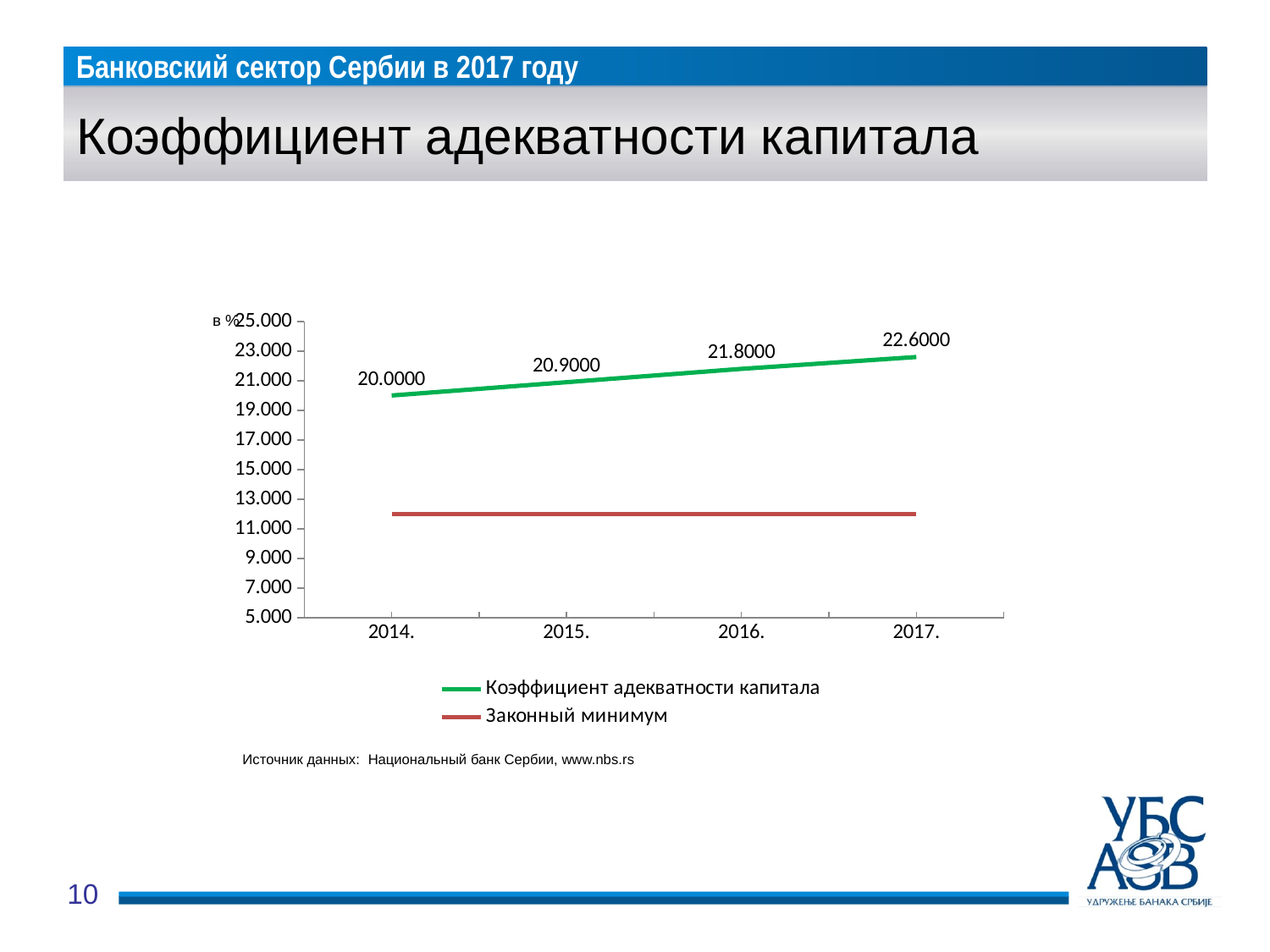
What is the value of the capital adequacy ratio for 2017? 22.6000 What kind of chart is shown on the slide? line chart In which year is the capital adequacy ratio lowest? 2014. Which is larger, the capital adequacy ratio in 2015 or in 2016? 2016 How many series does the legend list? 2 In which year is the capital adequacy ratio highest? 2017. What is the value of the capital adequacy ratio (Коэффициент адекватности капитала) for 2014? 20.0000 How many years are plotted on the x axis? 4 Does the capital adequacy ratio rise or fall from 2014 to 2017? rise Is the value of the legal minimum (Законный минимум) line greater or less than 15.000? less What is the value of the capital adequacy ratio for 2016? 21.8000 What is the difference between the capital adequacy ratio in 2017 and in 2014? 2.6000